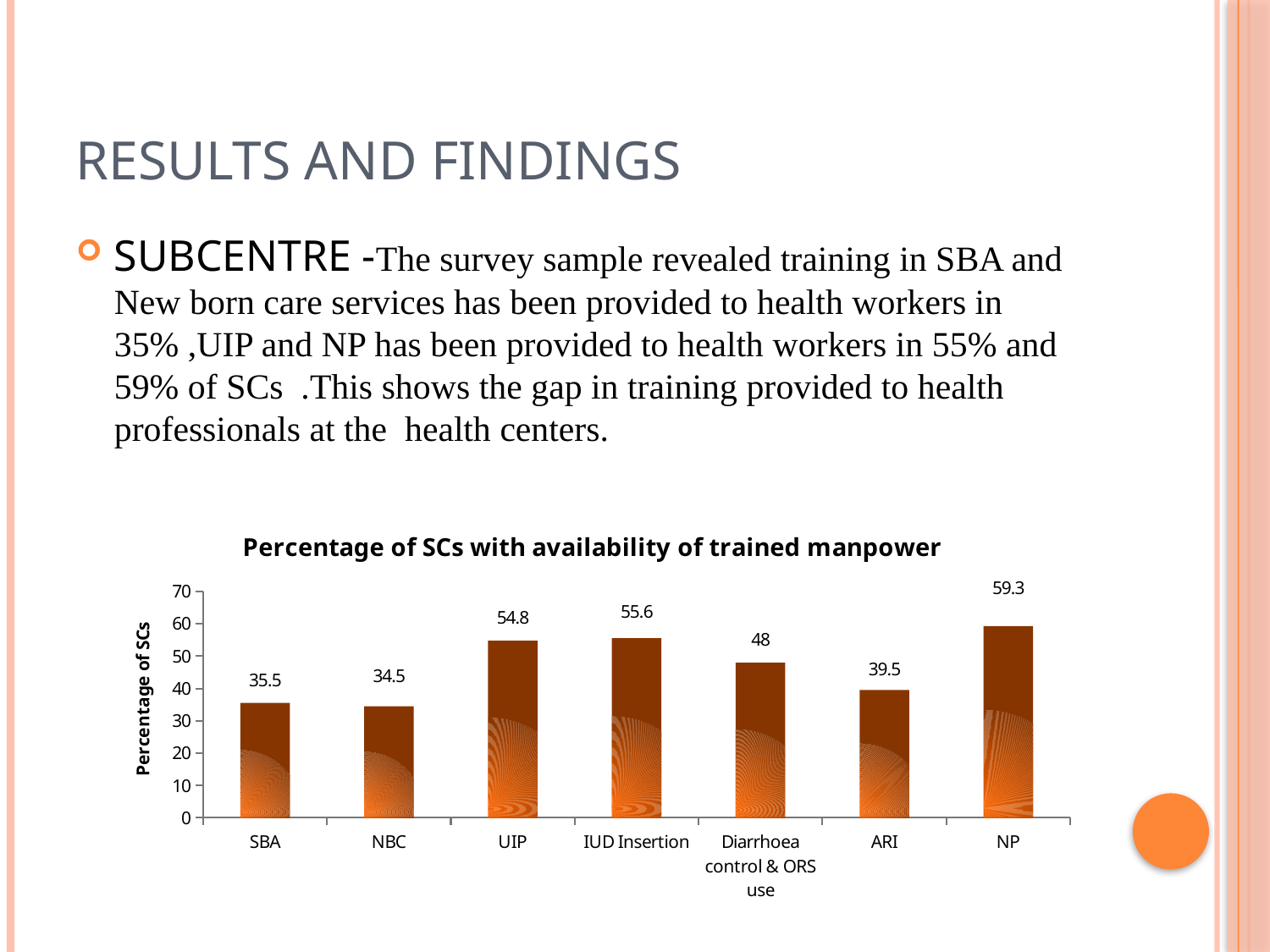
What is the difference between the values for NP and SBA? 23.8 Which category has the lowest value in the chart? NBC How many categories are shown on the x axis of the chart? 7 Is the value for Diarrhoea control & ORS use greater or less than 40? greater What is the value for ARI? 39.5 What is the title of the chart? Percentage of SCs with availability of trained manpower What is the value for Diarrhoea control & ORS use? 48 What is the label of the vertical axis of the chart? Percentage of SCs Which is larger, the value for IUD Insertion or the value for UIP? IUD Insertion Which category has the highest percentage of SCs with trained manpower? NP What kind of chart is shown on the slide? Bar chart What is the value for UIP in the chart? 54.8